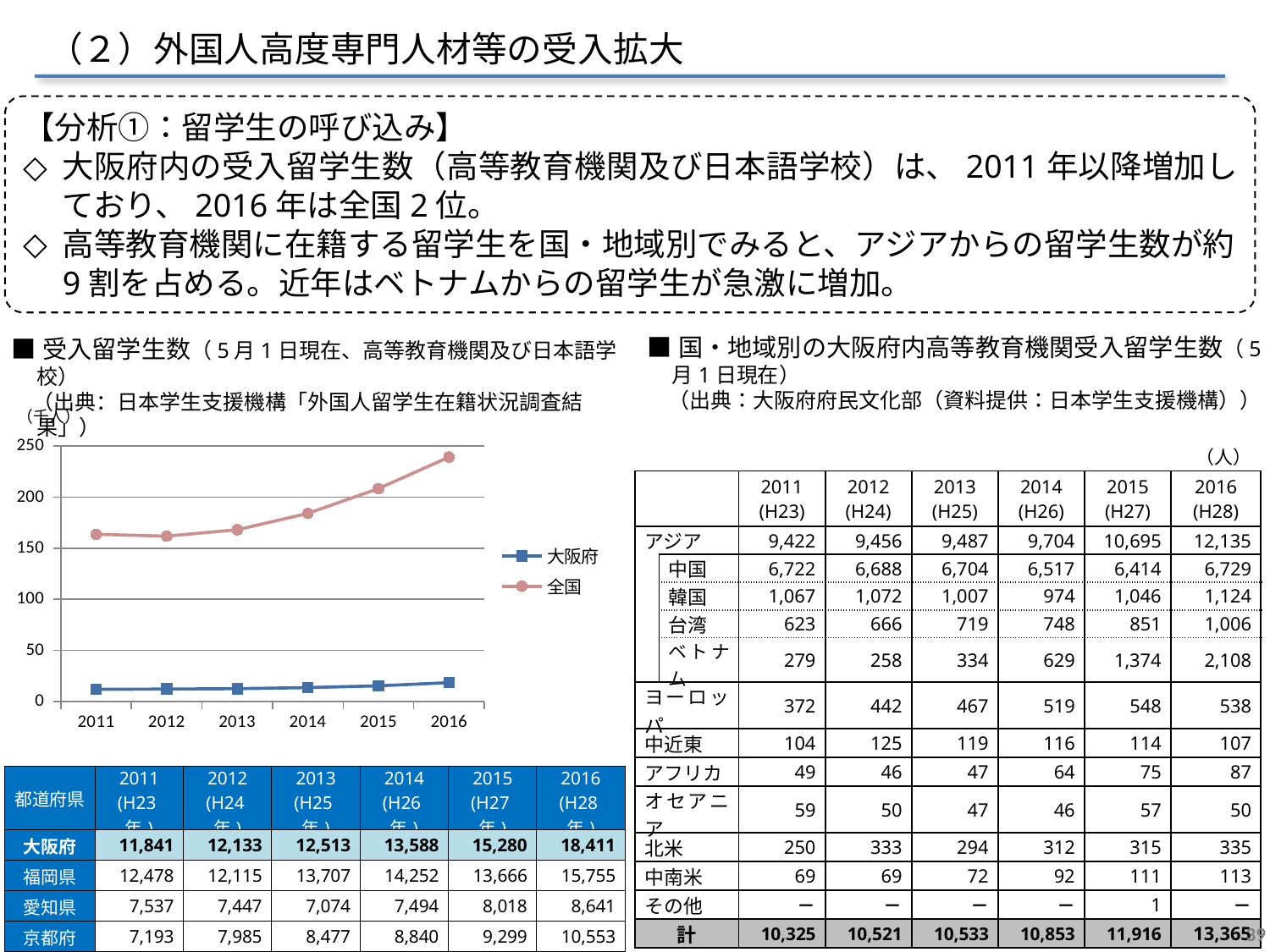
How many series does the legend of the line chart list? 2 What kind of chart is shown on the slide? line chart In the line chart, which series has the larger value in 2016, 大阪府 or 全国? 全国 In the line chart, is the value for 全国 in 2016 greater or less than 200? greater In the line chart, is the value for 全国 in 2014 greater or less than 200? less What is the unit shown on the y axis of the line chart? 千人 In the line chart, is the value for 全国 in 2011 greater or less than 150? greater What are the two series named in the legend of the line chart? 大阪府 and 全国 How many years are plotted along the x axis of the line chart? 6 In the line chart, do the values for 全国 rise or fall from 2013 to 2016? rise In the line chart, which year has the highest value for 全国? 2016